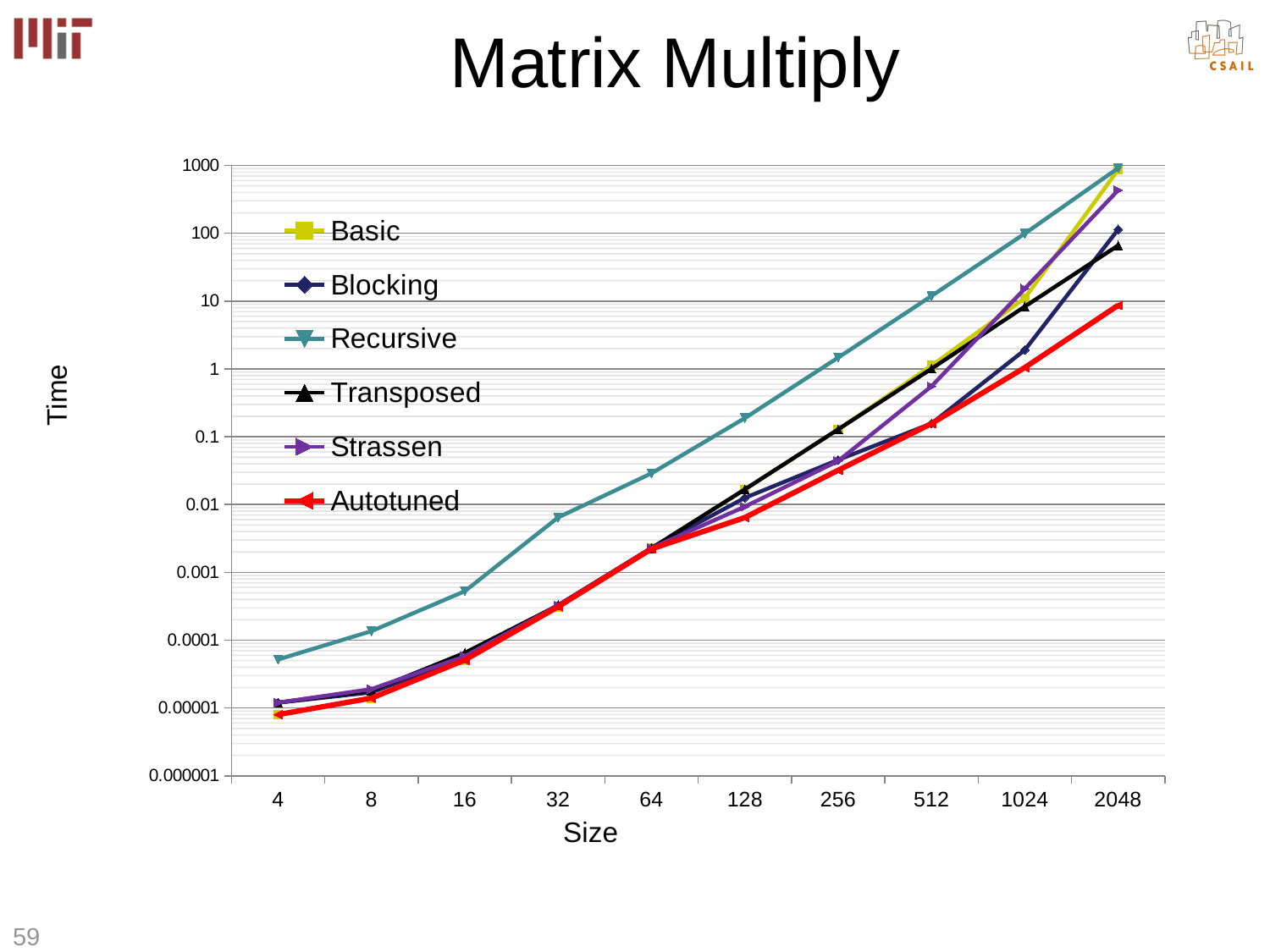
Which series has the lowest time at size 2048? Autotuned How many size values are plotted along the x axis? 10 Is the time for Transposed at size 2048 greater or less than 100? less Which series has the highest time at size 512? Recursive What kind of chart is shown on the slide? line chart Is the time for Strassen at size 2048 greater or less than 1000? less How many series does the legend list? 6 Is the time for Recursive at size 4 greater or less than 0.00001? greater Do the times for the Autotuned series rise or fall as size increases? rise What is the label of the x axis? Size At size 256, which is larger: the time for Recursive or the time for Autotuned? Recursive